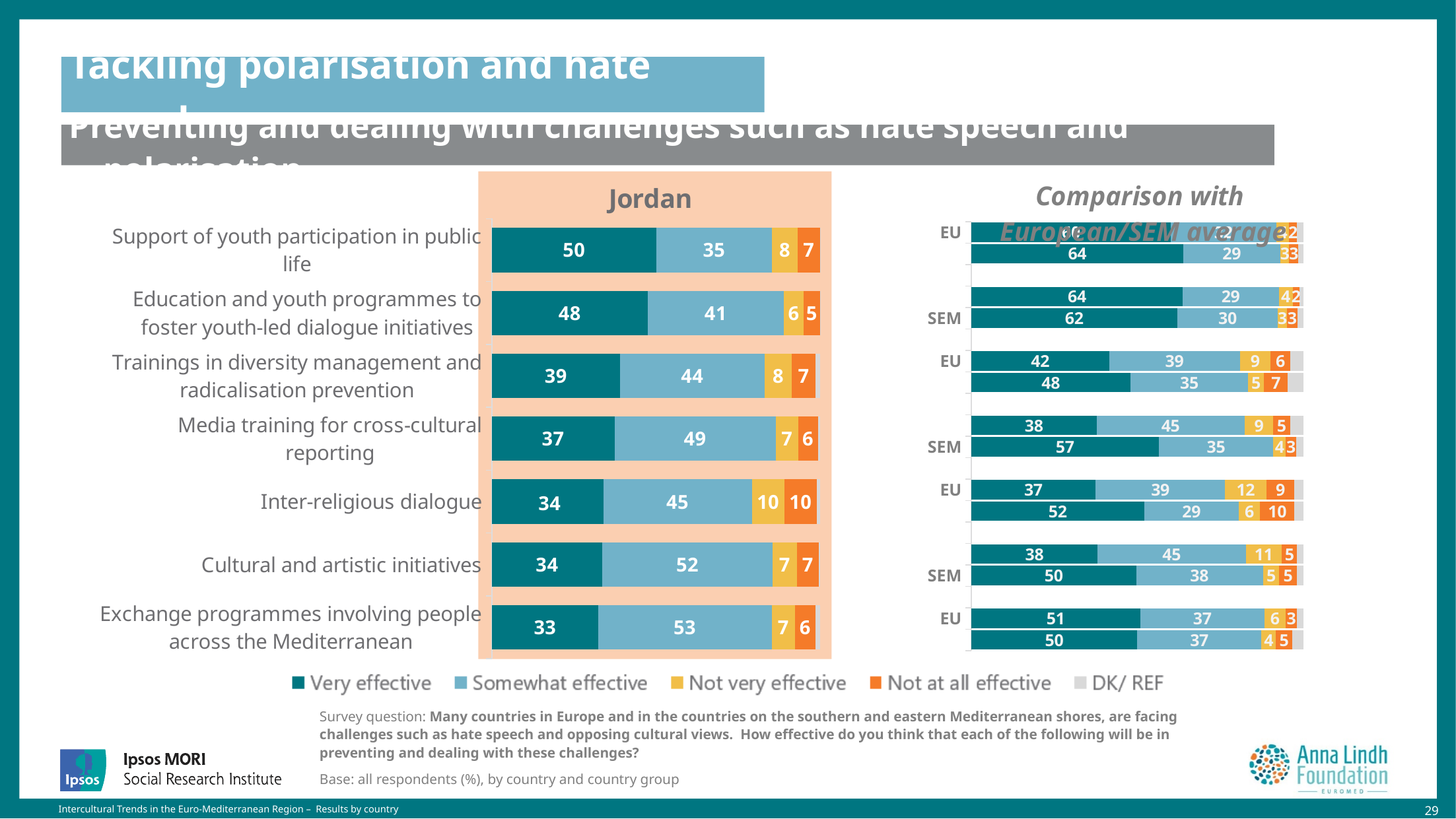
How many series does the legend list? 5 In the Jordan chart, what is the difference between the 'Very effective' values for 'Support of youth participation in public life' and 'Exchange programmes involving people across the Mediterranean'? 17 In the Jordan chart, which category has the highest 'Very effective' value? Support of youth participation in public life In the Jordan chart, what percentage rated 'Support of youth participation in public life' as very effective? 50 In the Jordan chart, which category has the lowest 'Very effective' value? Exchange programmes involving people across the Mediterranean How many categories are shown in the Jordan chart? 7 What type of chart is the Jordan chart? Stacked bar chart Which legend entry is shown in dark teal? Very effective In the Jordan chart, what is the 'Not very effective' value for 'Education and youth programmes to foster youth-led dialogue initiatives'? 6 In the Jordan chart, what is the 'Not at all effective' value for 'Inter-religious dialogue'? 10 In the Jordan chart, what is the 'Somewhat effective' value for 'Exchange programmes involving people across the Mediterranean'? 53 In the Jordan chart, which has the larger 'Somewhat effective' value: 'Cultural and artistic initiatives' or 'Media training for cross-cultural reporting'? Cultural and artistic initiatives